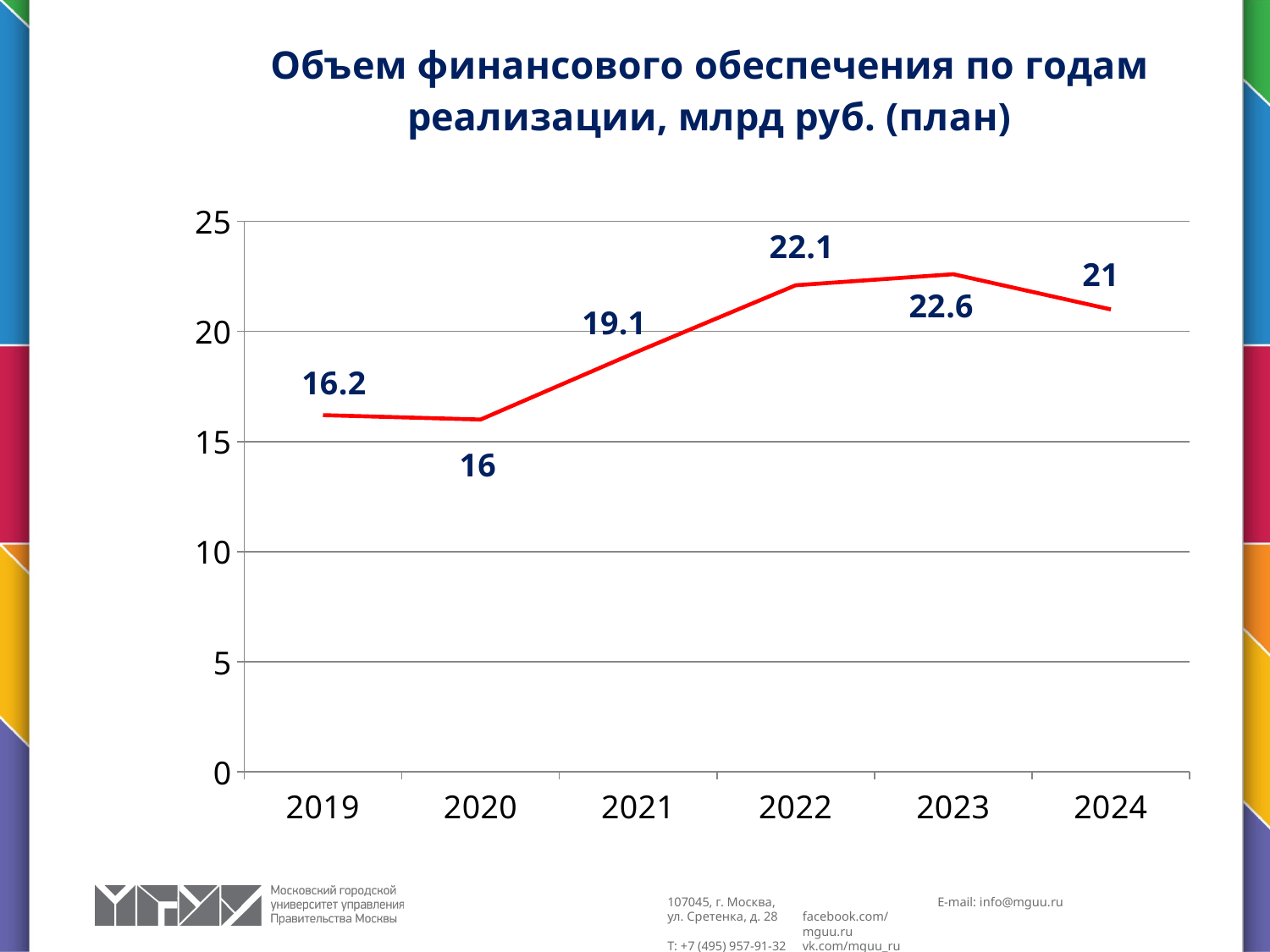
What is the value for 2022? 22.1 What is the difference between the values for 2023 and 2020? 6.6 What is the value for 2024? 21 What is the value for 2019? 16.2 Do the values rise or fall from 2020 to 2023? rise Which year has the highest value? 2023 Which is larger, the value for 2022 or the value for 2024? 2022 Which year has the lowest value? 2020 How many years are plotted on the x axis? 6 Is the value for 2021 greater or less than 20? less What is the difference between the values for 2021 and 2019? 2.9 What kind of chart is shown on the slide? line chart